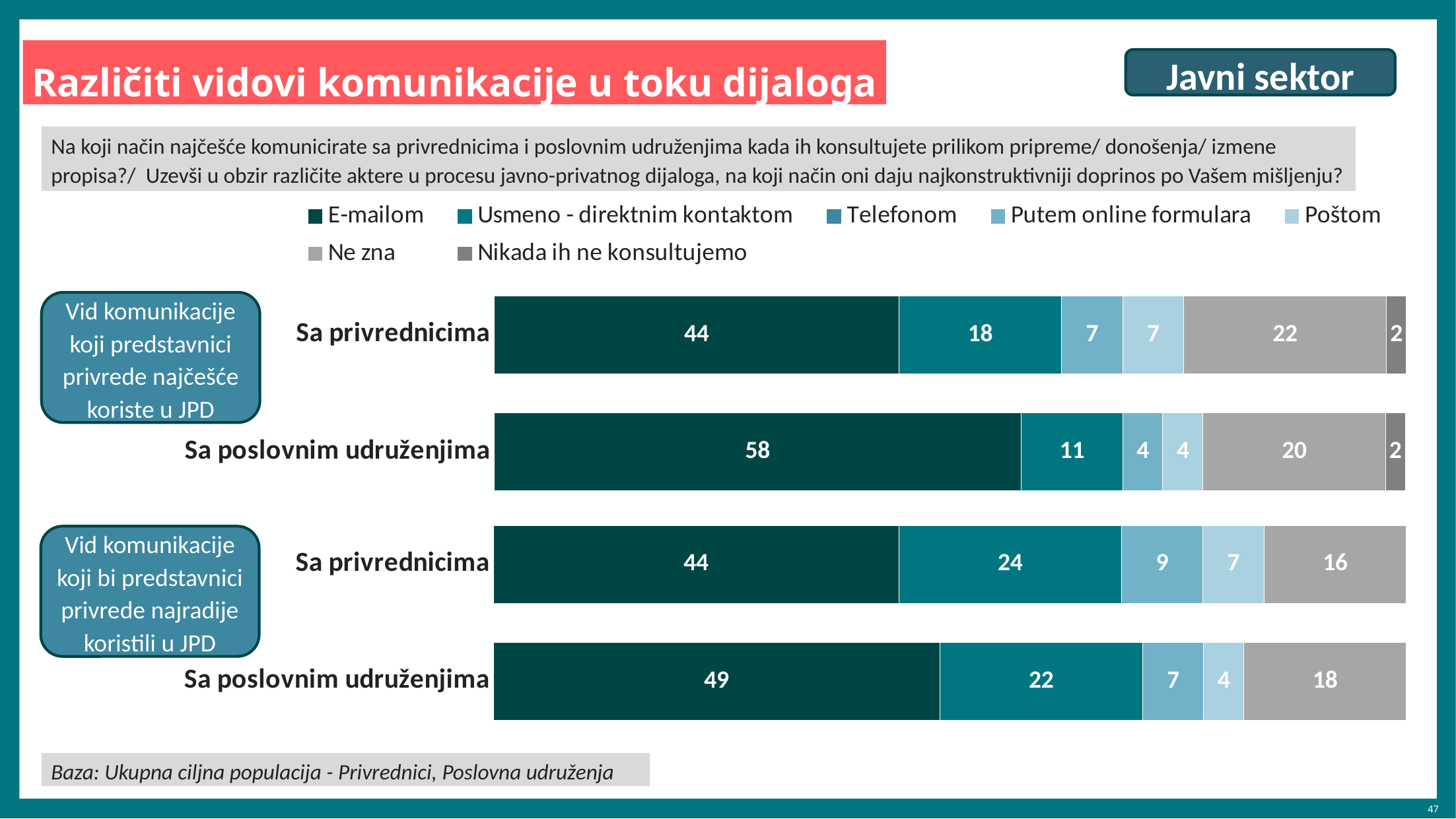
In the first group (najčešće koriste), which segment is the largest in the Sa poslovnim udruženjima bar? E-mailom In the second group (najradije koristili), what is the Usmeno - direktnim kontaktom value for Sa privrednicima? 24 How many bars are plotted in the chart? 4 What is the total of the Sa privrednicima bar in the second group (najradije koristili)? 100 In the first group (najčešće koriste), what is the E-mailom value for Sa poslovnim udruženjima? 58 In the second group (najradije koristili), what is the Ne zna value for Sa poslovnim udruženjima? 18 How many series does the legend list? 7 What kind of chart is shown on the slide? Stacked bar chart In the first group (Vid komunikacije koji predstavnici privrede najčešće koriste u JPD), what is the E-mailom value for Sa privrednicima? 44 In the first group (najčešće koriste), what is the Nikada ih ne konsultujemo value for Sa privrednicima? 2 In the first group (najčešće koriste), what is the difference between the E-mailom values for Sa poslovnim udruženjima and Sa privrednicima? 14